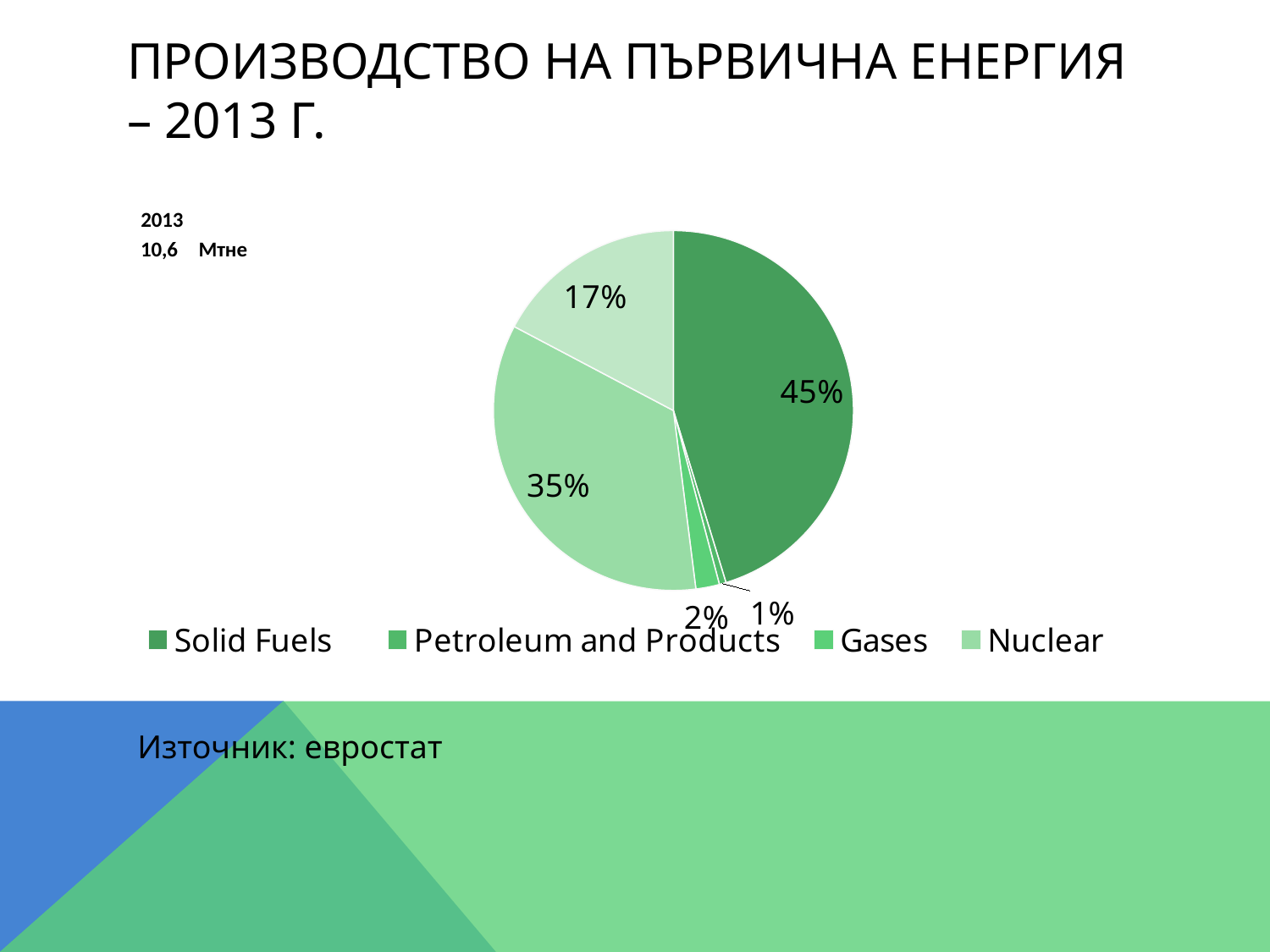
What share of the pie does Gases have? 2% How many entries does the legend list? 4 What kind of chart is shown on the slide? Pie chart How many percentage points larger is the Solid Fuels slice than the Nuclear slice? 10 percentage points Which legend category has the smallest slice of the pie? Petroleum and Products What total value is printed next to the year 2013 above the chart? 10,6 Мтне Which slice is larger, Gases or Petroleum and Products? Gases What share of the pie does Petroleum and Products have? 1% How many slices does the pie chart have? 5 Which legend category has the largest slice of the pie? Solid Fuels What share of the pie does Nuclear have? 35% What share of the pie does Solid Fuels have? 45%